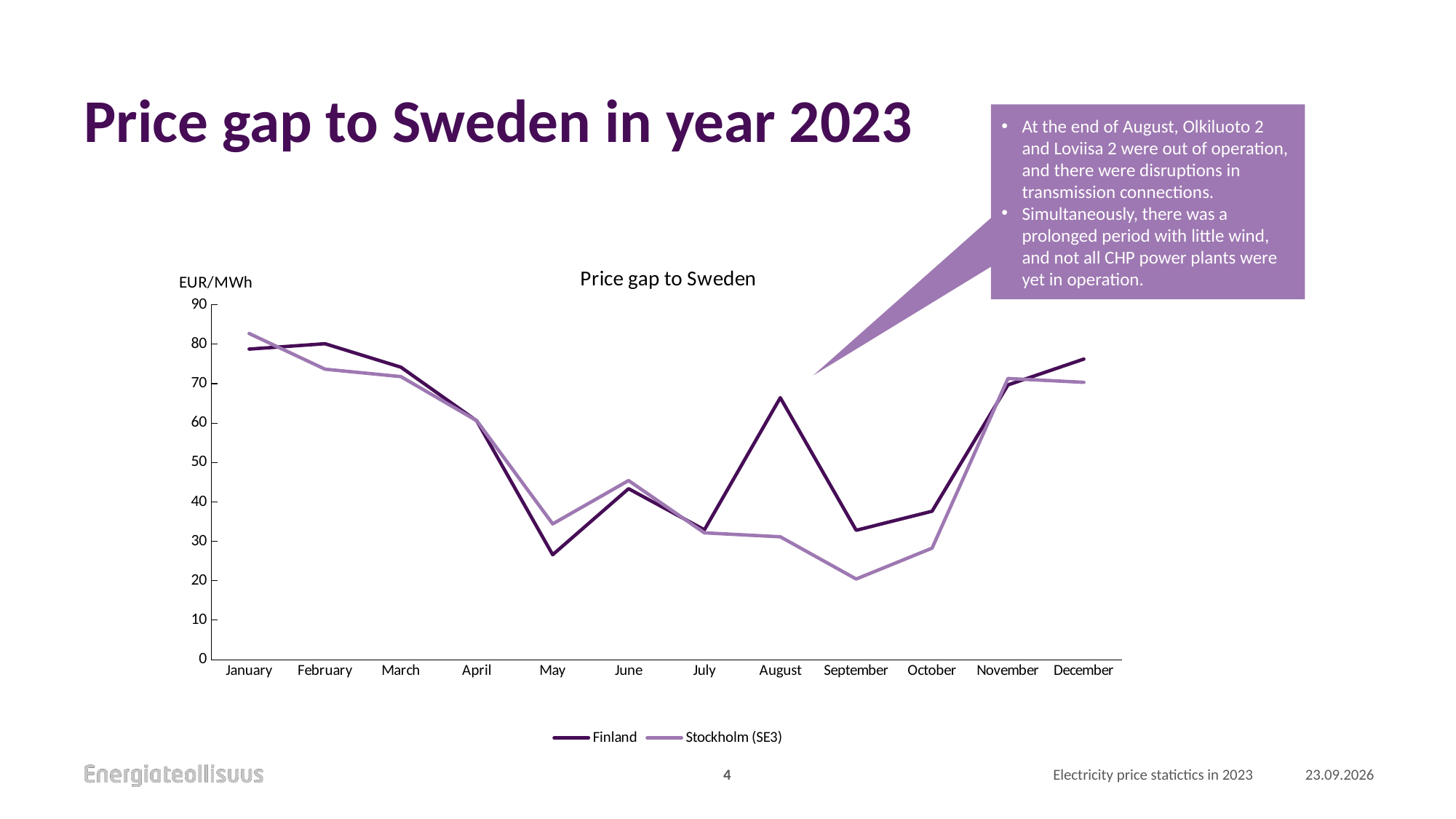
Is the value for Finland in August greater or less than 60? greater In August, which series has the higher value, Finland or Stockholm (SE3)? Finland In May, which series has the higher value, Finland or Stockholm (SE3)? Stockholm (SE3) In which month is the Stockholm (SE3) line at its lowest? September How many series does the legend list? 2 What kind of chart is shown on the slide? line chart Does the Finland line rise or fall from January to May? fall In which month is the Finland line at its lowest? May How many months are plotted along the x axis? 12 In which month is the Stockholm (SE3) line at its highest? January Is the value for Stockholm (SE3) in September greater or less than 30? less What unit is shown on the y axis of the chart? EUR/MWh